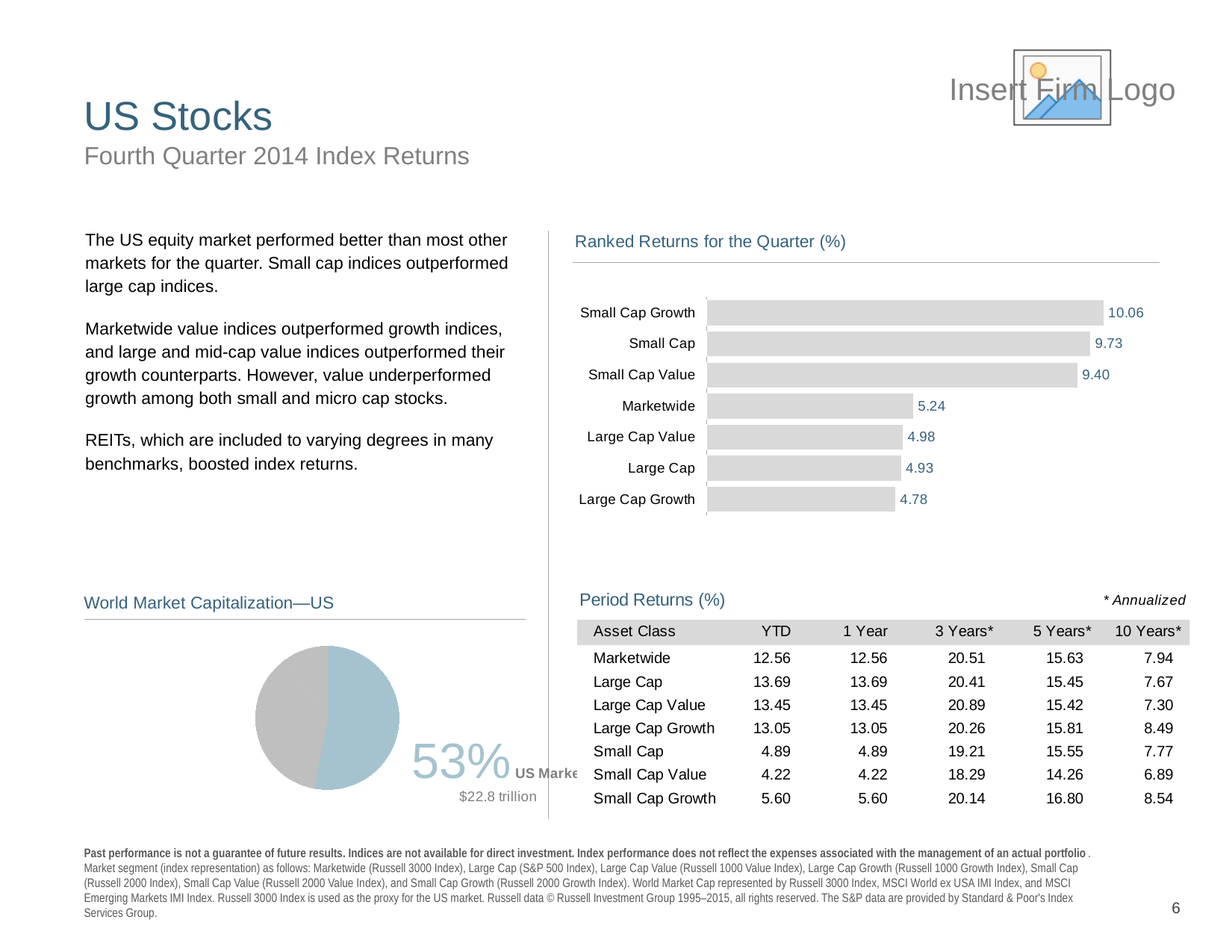
In the Ranked Returns for the Quarter chart, what is the difference between Small Cap and Large Cap? 4.80 In the Ranked Returns for the Quarter chart, which is larger, Small Cap Value or Marketwide? Small Cap Value In the Ranked Returns for the Quarter chart, which category has the lowest value? Large Cap Growth How many categories are shown in the Ranked Returns for the Quarter chart? 7 In the Ranked Returns for the Quarter chart, what is the value for Marketwide? 5.24 What kind of chart is the Ranked Returns for the Quarter chart? Bar chart In the Ranked Returns for the Quarter chart, which category has the highest value? Small Cap Growth In the World Market Capitalization—US chart, what share of the pie does the US Market slice represent? 53% In the Ranked Returns for the Quarter chart, what is the value for Small Cap Growth? 10.06 In the Ranked Returns for the Quarter chart, what is the value for Large Cap Growth? 4.78 What dollar value is shown beneath the 53% label in the World Market Capitalization—US chart? $22.8 trillion What kind of chart is the World Market Capitalization—US chart? Pie chart